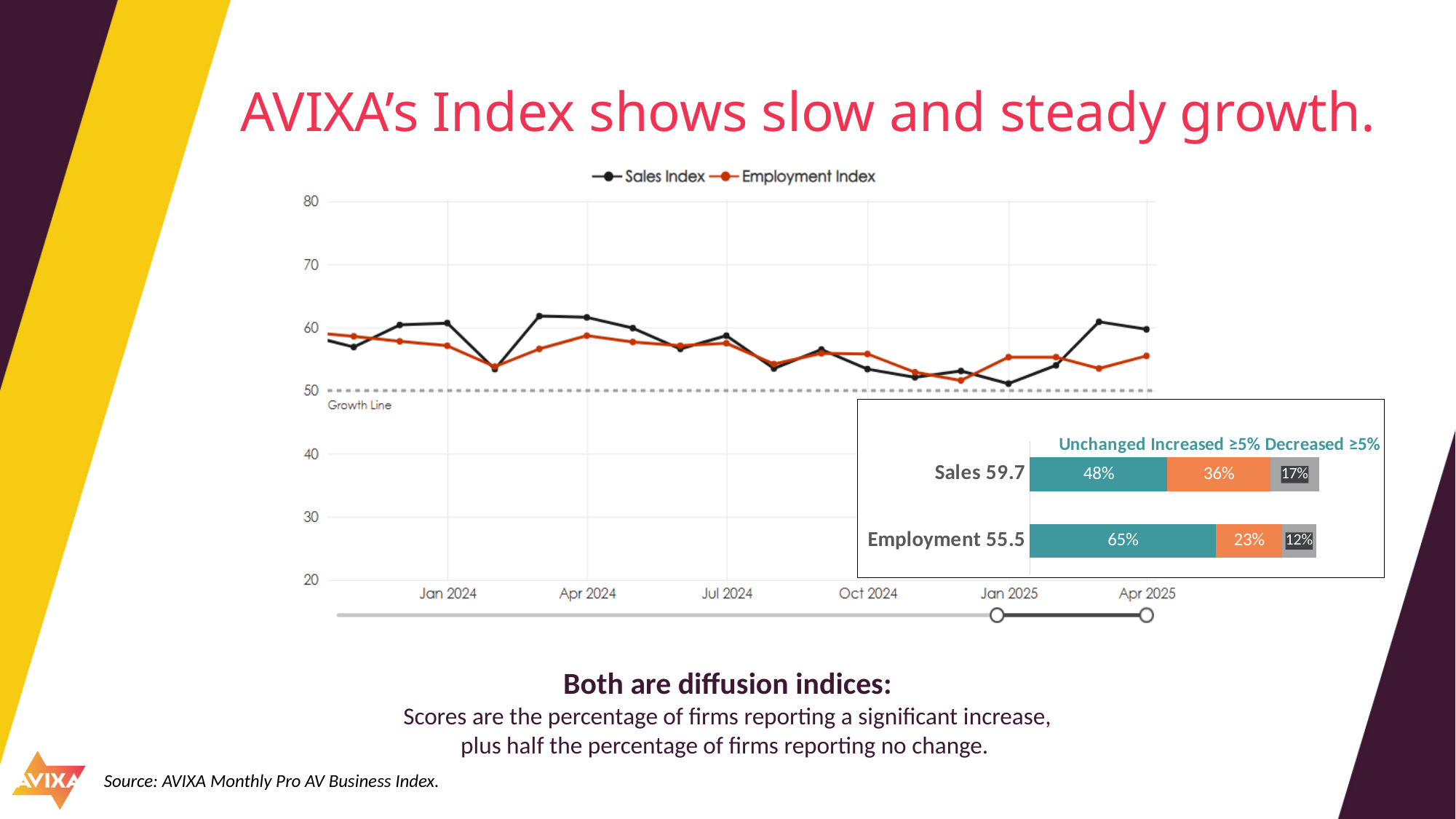
In the line chart, is the Employment Index value at Jan 2025 greater or less than 60? less In the inset stacked bar chart, which is larger: the Unchanged share for Sales or the Unchanged share for Employment? Employment In the inset stacked bar chart, what index value is shown next to the Employment label? 55.5 In the inset stacked bar chart, what is the difference between the Unchanged share for Employment (65%) and for Sales (48%)? 17 percentage points In the inset stacked bar chart, what percentage of firms reported Increased ≥5% for Employment? 23% What kind of chart is the large chart showing the Sales Index and Employment Index over time? Line chart In the inset stacked bar chart, what percentage of firms reported Decreased ≥5% for Sales? 17% In the line chart, is the Sales Index value at Apr 2024 greater or less than 60? greater In the line chart, at what value is the dotted Growth Line drawn? 50 What are the two series named in the line chart's legend? Sales Index and Employment Index In the line chart, how many series does the legend list? 2 In the inset stacked bar chart, what percentage of firms reported Unchanged for Sales? 48%